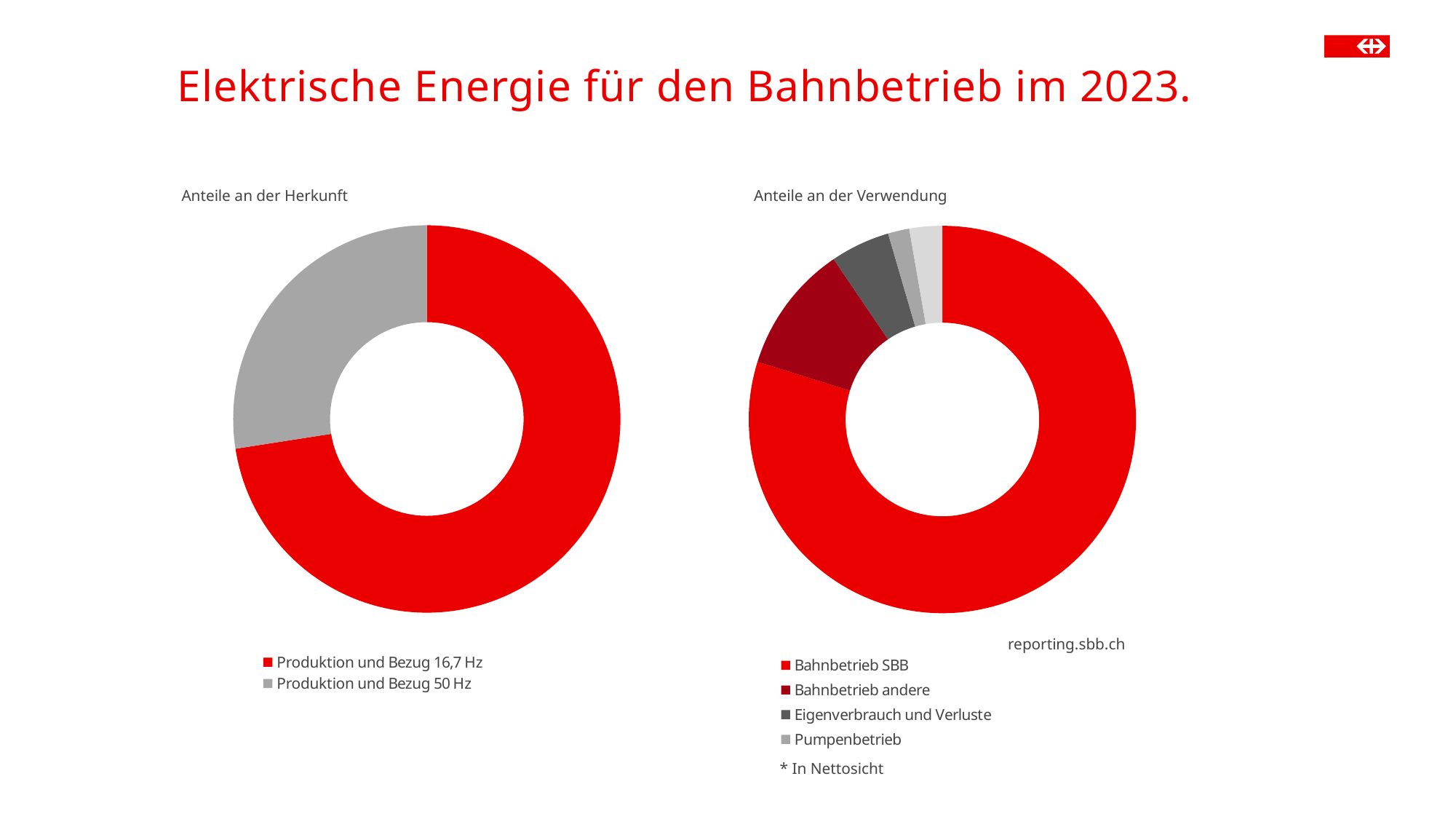
What is the title of the slide? Elektrische Energie für den Bahnbetrieb im 2023. How many categories does the legend of the 'Anteile an der Verwendung' chart list? 4 In the 'Anteile an der Verwendung' chart, which is larger: Bahnbetrieb andere or Eigenverbrauch und Verluste? Bahnbetrieb andere What kind of chart is the 'Anteile an der Verwendung' chart? Pie chart (donut) In the 'Anteile an der Verwendung' chart, which category has the largest share? Bahnbetrieb SBB In the 'Anteile an der Herkunft' chart, which is larger: Produktion und Bezug 16,7 Hz or Produktion und Bezug 50 Hz? Produktion und Bezug 16,7 Hz What kind of chart is the 'Anteile an der Herkunft' chart? Pie chart (donut) In the 'Anteile an der Herkunft' chart, which category has the largest share? Produktion und Bezug 16,7 Hz In the 'Anteile an der Verwendung' chart, which is larger: Bahnbetrieb SBB or Pumpenbetrieb? Bahnbetrieb SBB In the 'Anteile an der Herkunft' chart, which category has the smallest share? Produktion und Bezug 50 Hz What colour is the Bahnbetrieb SBB slice in the 'Anteile an der Verwendung' chart? Red How many categories does the legend of the 'Anteile an der Herkunft' chart list? 2